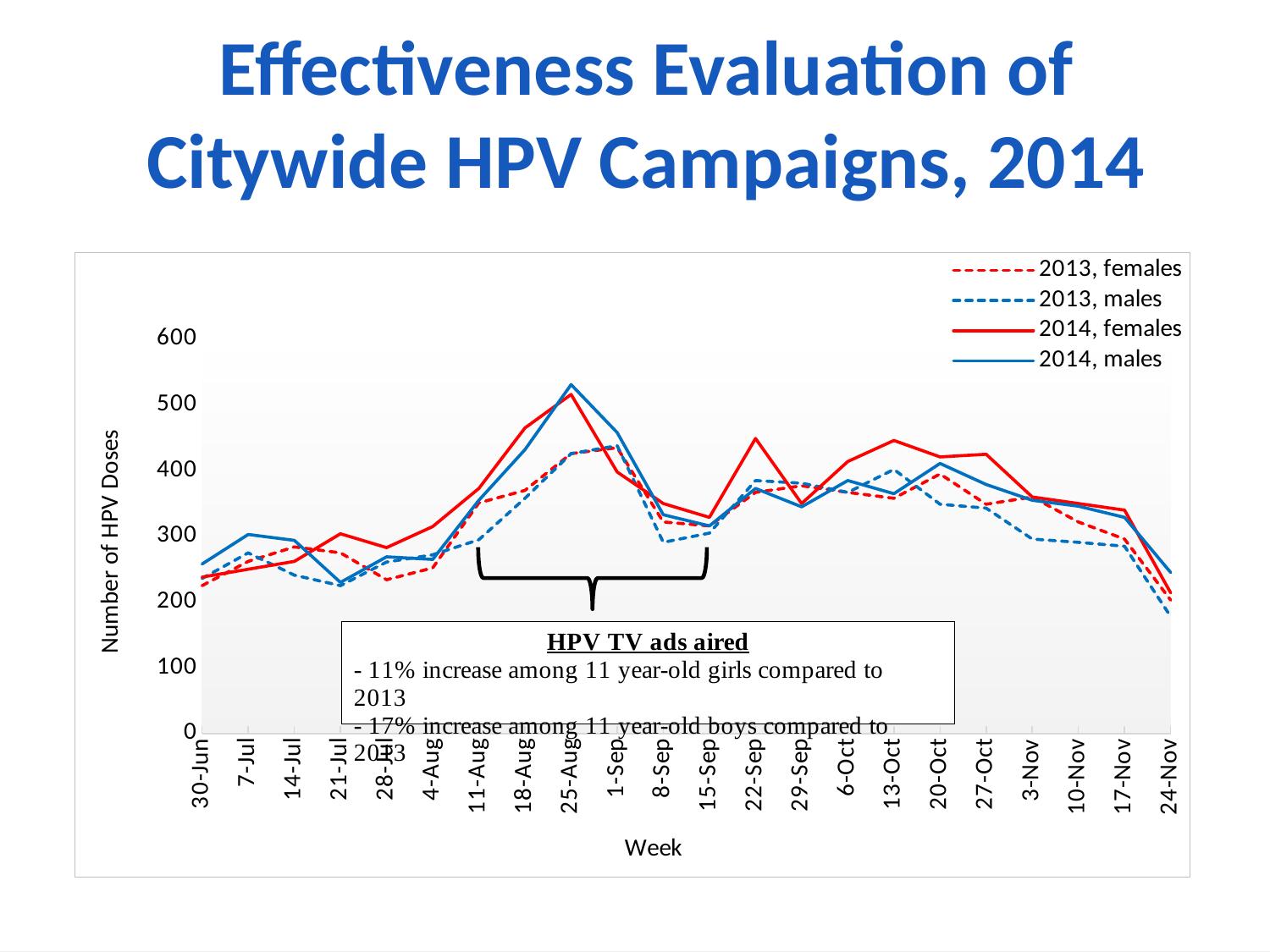
What kind of chart is shown on the slide? line chart In which week does the 2014, females series reach its highest value? 25-Aug What is the title of the y axis? Number of HPV Doses What is the title of the x axis? Week In which week does the 2013, males series reach its lowest value? 24-Nov How many series does the legend list? 4 At 25-Aug, which is larger: the value for 2014, males or the value for 2013, males? 2014, males Is the value for 2014, males at 25-Aug greater or less than 500? greater In which week does the 2014, males series reach its highest value? 25-Aug Is the value for 2013, males at 24-Nov greater or less than 200? less Is the value for 2014, females at 13-Oct greater or less than 400? greater How many weeks are plotted along the x axis? 22